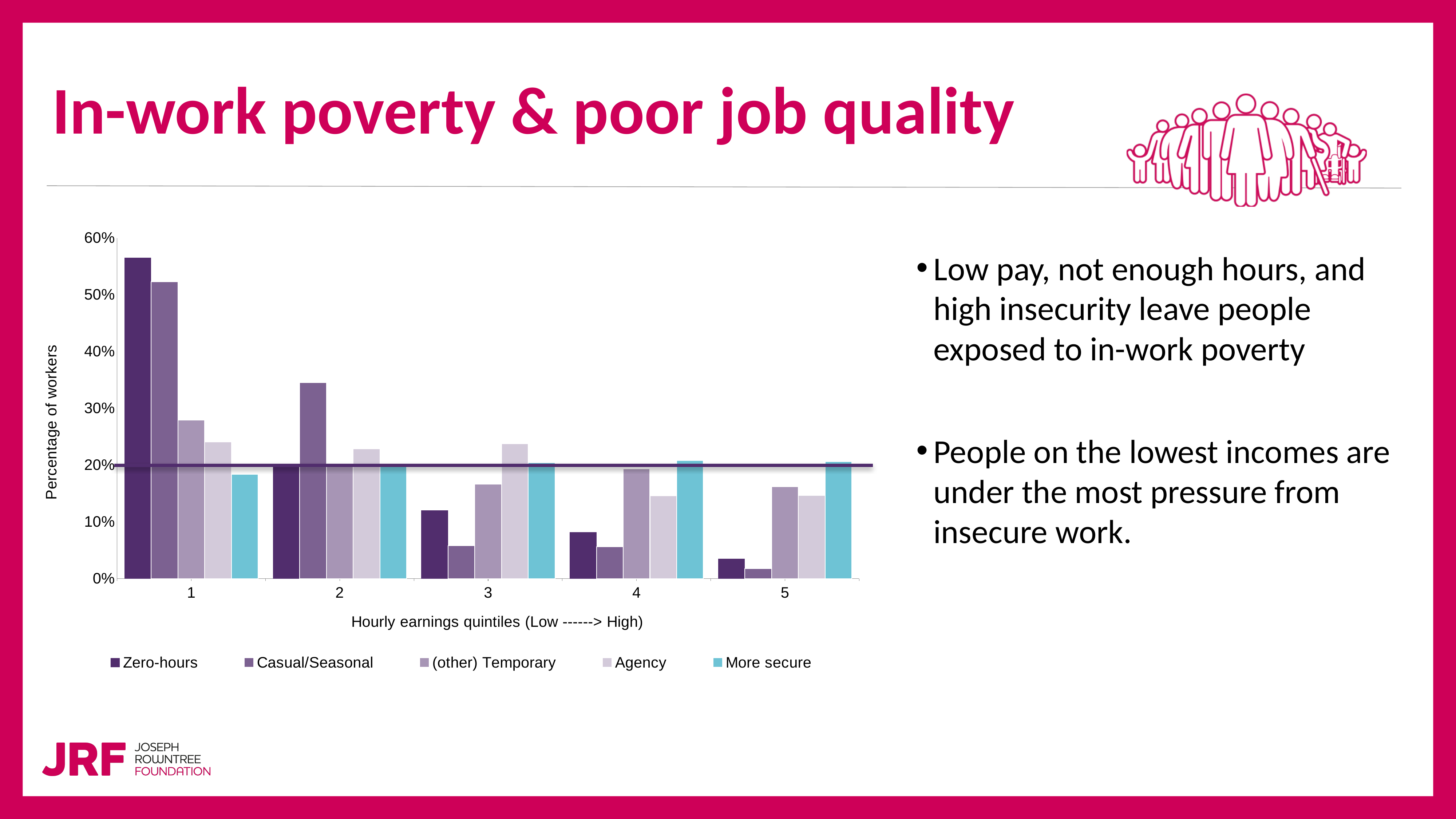
What kind of chart is shown on the slide? Bar chart What is the label on the y axis of the chart? Percentage of workers Is the value for Casual/Seasonal in quintile 2 greater or less than 30%? greater In quintile 5, which series has the lowest value? Casual/Seasonal Is the value for Zero-hours in quintile 1 greater or less than 50%? greater How many series does the chart legend list? 5 In quintile 2, which series has the highest value? Casual/Seasonal How many hourly earnings quintiles are shown on the x axis? 5 Which hourly earnings quintile has the lowest value for Zero-hours? 5 Which hourly earnings quintile has the highest value for Zero-hours? 1 Do the Zero-hours values rise or fall as the hourly earnings quintile goes from 1 to 5? fall Is the value for Casual/Seasonal in quintile 5 greater or less than 10%? less